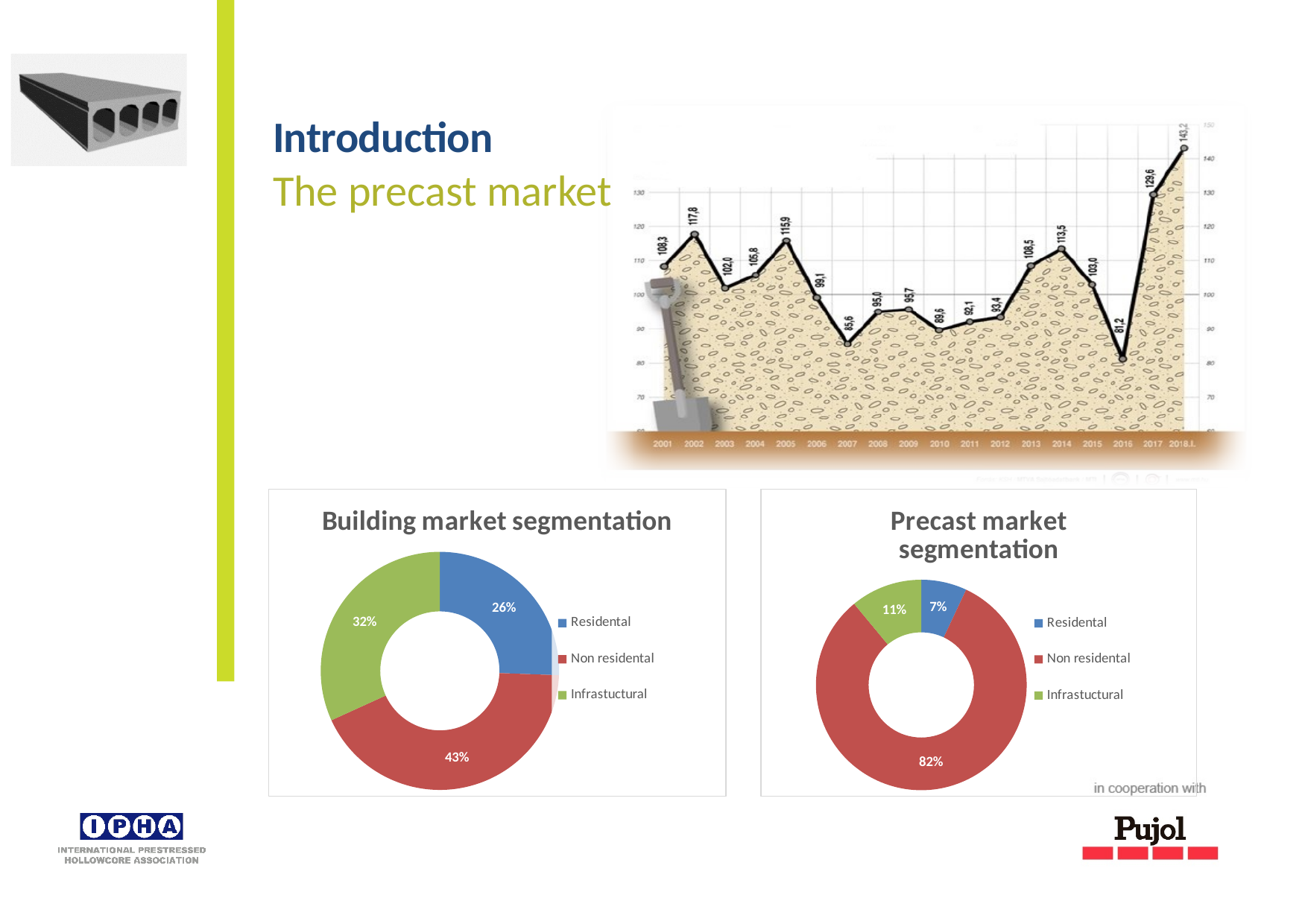
In the Building market segmentation chart, which segment has the smallest share? Residental In the line chart at the top right, what is the value for 2002? 117,8 In the Building market segmentation chart, what share is Non residential? 43% In the Precast market segmentation chart, what share is Residental? 7% In the line chart at the top right, what is the value for 2016? 81,2 In the line chart at the top right, which year has the highest value? 2018.I. In the Building market segmentation chart, what share is Infrastuctural? 32% Which is larger: the Residental share in the Building market segmentation chart or the Residental share in the Precast market segmentation chart? Building market segmentation In the Precast market segmentation chart, what is the difference between the Non residental and Infrastuctural shares? 71% In the Precast market segmentation chart, which segment has the largest share? Non residental How many segments does the legend of the Precast market segmentation chart list? 3 What kind of chart is the Building market segmentation chart? Doughnut chart